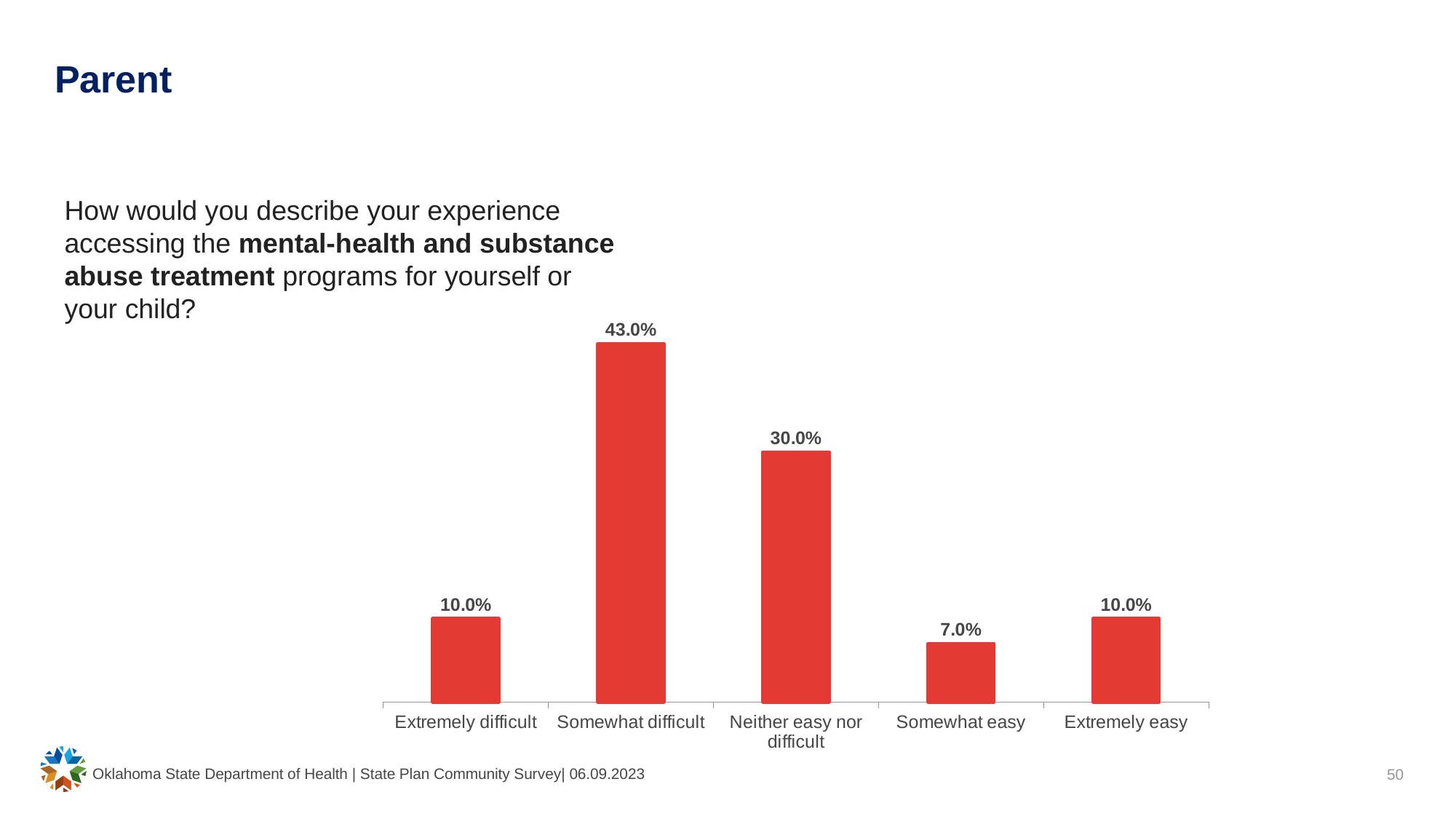
What colour are the bars in the chart? Red What is the difference between the values for Extremely easy and Somewhat easy? 3.0% What is the value for Somewhat easy? 7.0% Which is larger, the value for Neither easy nor difficult or the value for Extremely easy? Neither easy nor difficult What percentage of parents described their experience as Somewhat difficult? 43.0% How many categories are shown on the chart? 5 What is the value for Neither easy nor difficult? 30.0% What is the difference between the values for Somewhat difficult and Neither easy nor difficult? 13.0% Which category has the lowest value? Somewhat easy What is the value for Extremely difficult? 10.0% What kind of chart is shown on the slide? Bar chart Which category has the highest value? Somewhat difficult